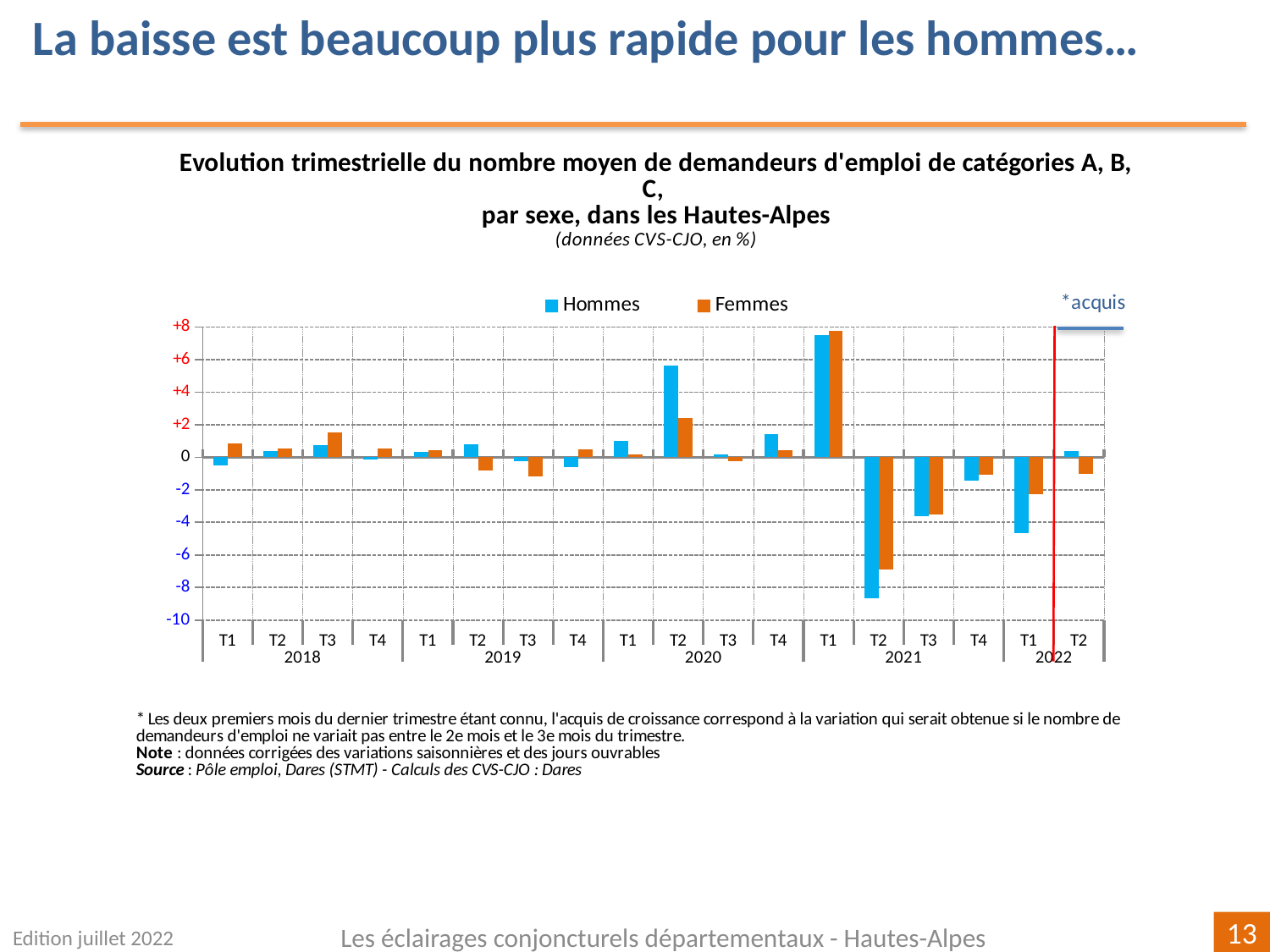
Is the value for Femmes in T2 2021 greater or less than -6? less How many quarters (T1–T4 periods) are plotted along the x axis? 18 In which quarter is the Hommes value the highest? T1 2021 How many series does the legend list? 2 Which colour represents the Hommes series in the legend? blue In which quarter is the Hommes value the lowest? T2 2021 Is the value for Hommes in T2 2020 greater or less than +4? greater Is the value for Hommes in T2 2021 greater or less than -8? less In which quarter is the Femmes value the lowest? T2 2021 In T2 2020, which series has the larger value, Hommes or Femmes? Hommes What kind of chart is shown on the slide? bar chart